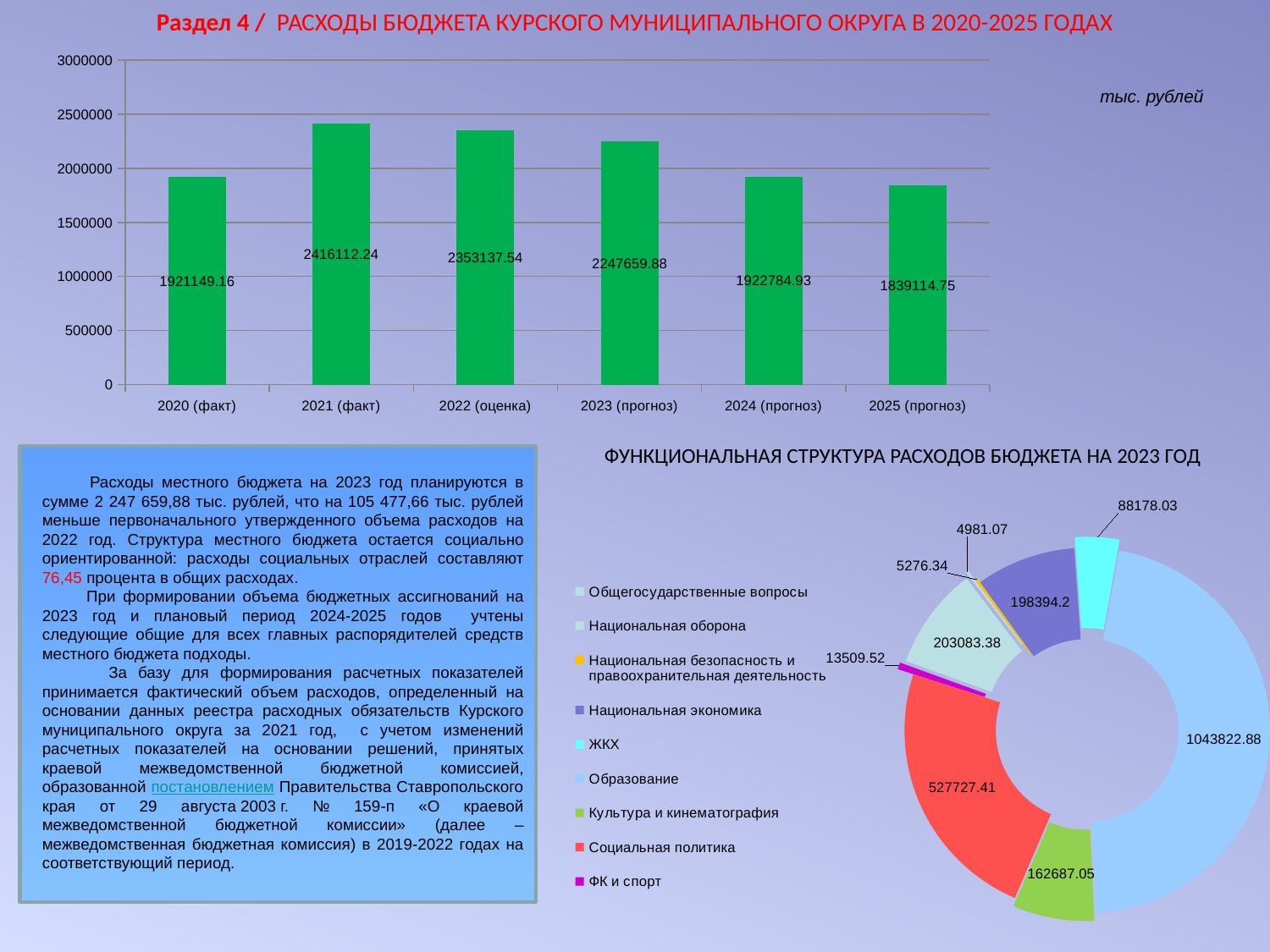
In the top bar chart, what is the value for 2025 (прогноз)? 1839114.75 In the top bar chart, which year has the lowest value? 2025 (прогноз) In the top bar chart, what is the difference between the values for 2022 (оценка) and 2023 (прогноз)? 105477.66 In the top bar chart, do the values rise or fall from 2021 (факт) to 2025 (прогноз)? fall In the chart titled 'ФУНКЦИОНАЛЬНАЯ СТРУКТУРА РАСХОДОВ БЮДЖЕТА НА 2023 ГОД', what is the value for Образование? 1043822.88 How many entries does the legend of the chart titled 'ФУНКЦИОНАЛЬНАЯ СТРУКТУРА РАСХОДОВ БЮДЖЕТА НА 2023 ГОД' list? 9 In the chart titled 'ФУНКЦИОНАЛЬНАЯ СТРУКТУРА РАСХОДОВ БЮДЖЕТА НА 2023 ГОД', what is the value for Социальная политика? 527727.41 In the top bar chart, how many bars are shown? 6 In the top bar chart, which year has the highest value? 2021 (факт) In the top bar chart, what is the value for 2021 (факт)? 2416112.24 What type of chart is the top chart on the slide? bar chart In the chart titled 'ФУНКЦИОНАЛЬНАЯ СТРУКТУРА РАСХОДОВ БЮДЖЕТА НА 2023 ГОД', which is larger: Культура и кинематография or Национальная экономика? Национальная экономика